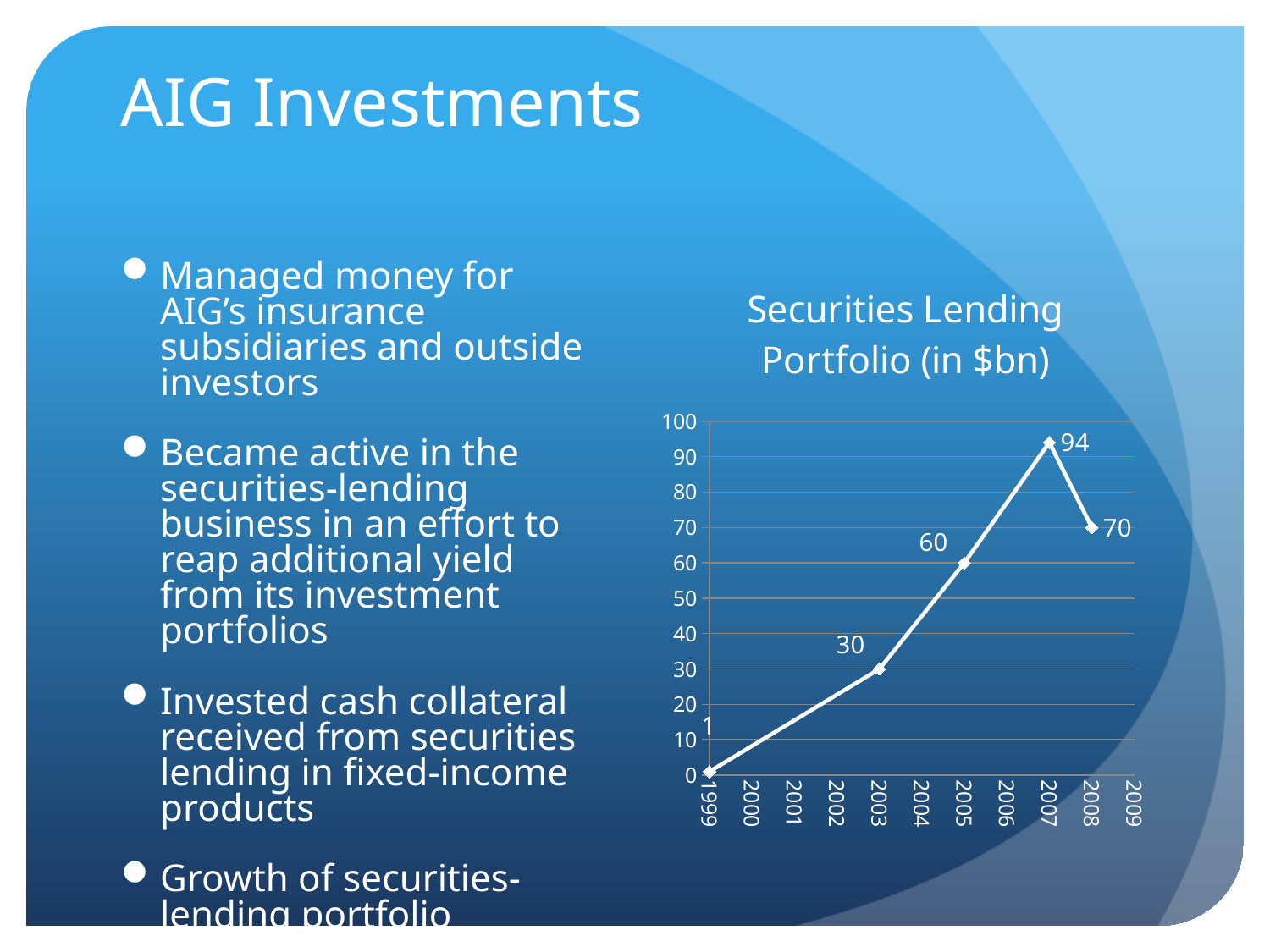
What is the value of the securities lending portfolio in 2008? 70 Does the portfolio value rise or fall between 2007 and 2008? fall What is the value of the securities lending portfolio in 2003? 30 What is the difference between the portfolio values in 2007 and 2008? 24 Which year has a larger portfolio value, 2005 or 2008? 2008 In which year is the securities lending portfolio value lowest? 1999 What is the value of the securities lending portfolio in 2007? 94 What is the value of the securities lending portfolio in 2005? 60 What type of chart is shown on the slide? line chart How many data points are plotted on the line? 5 What is the title of the chart? Securities Lending Portfolio (in $bn) In which year is the securities lending portfolio value highest? 2007